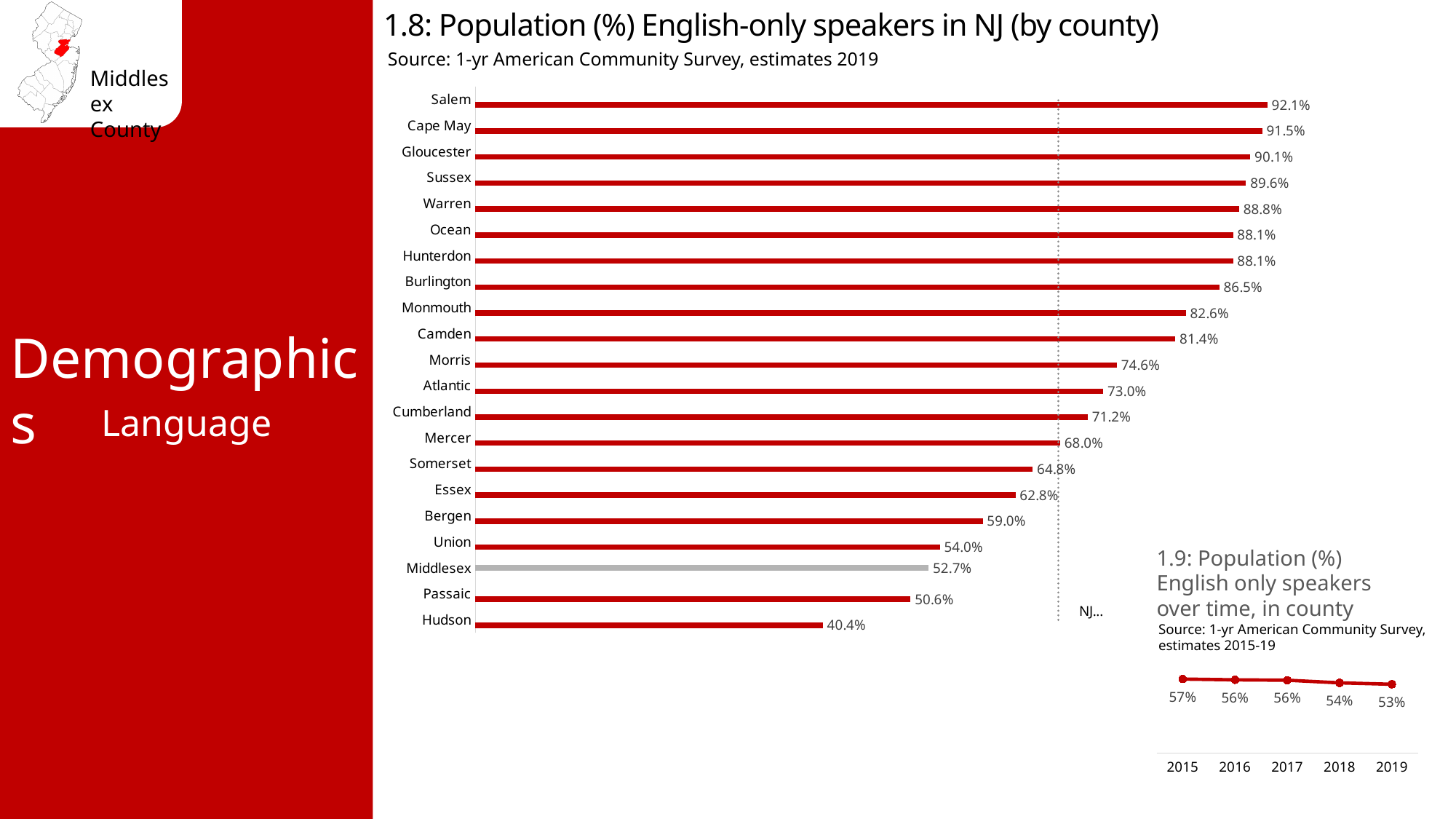
What kind of chart is chart 1.8? Bar chart In chart 1.8, how many counties are shown? 21 In chart 1.9, what is the value for 2015? 57% In chart 1.8, what is the difference between the values for Union and Middlesex? 1.3% In chart 1.9, do the values rise or fall from 2015 to 2019? Fall In chart 1.8, which is larger, the value for Bergen or the value for Passaic? Bergen In chart 1.8, what is the value for Salem? 92.1% In chart 1.9, what is the value for 2019? 53% In chart 1.8, which county's bar is shown in grey rather than red? Middlesex In chart 1.8, which county has the highest percentage of English-only speakers? Salem In chart 1.8, what is the value for Middlesex? 52.7% In chart 1.8, which county has the lowest percentage of English-only speakers? Hudson